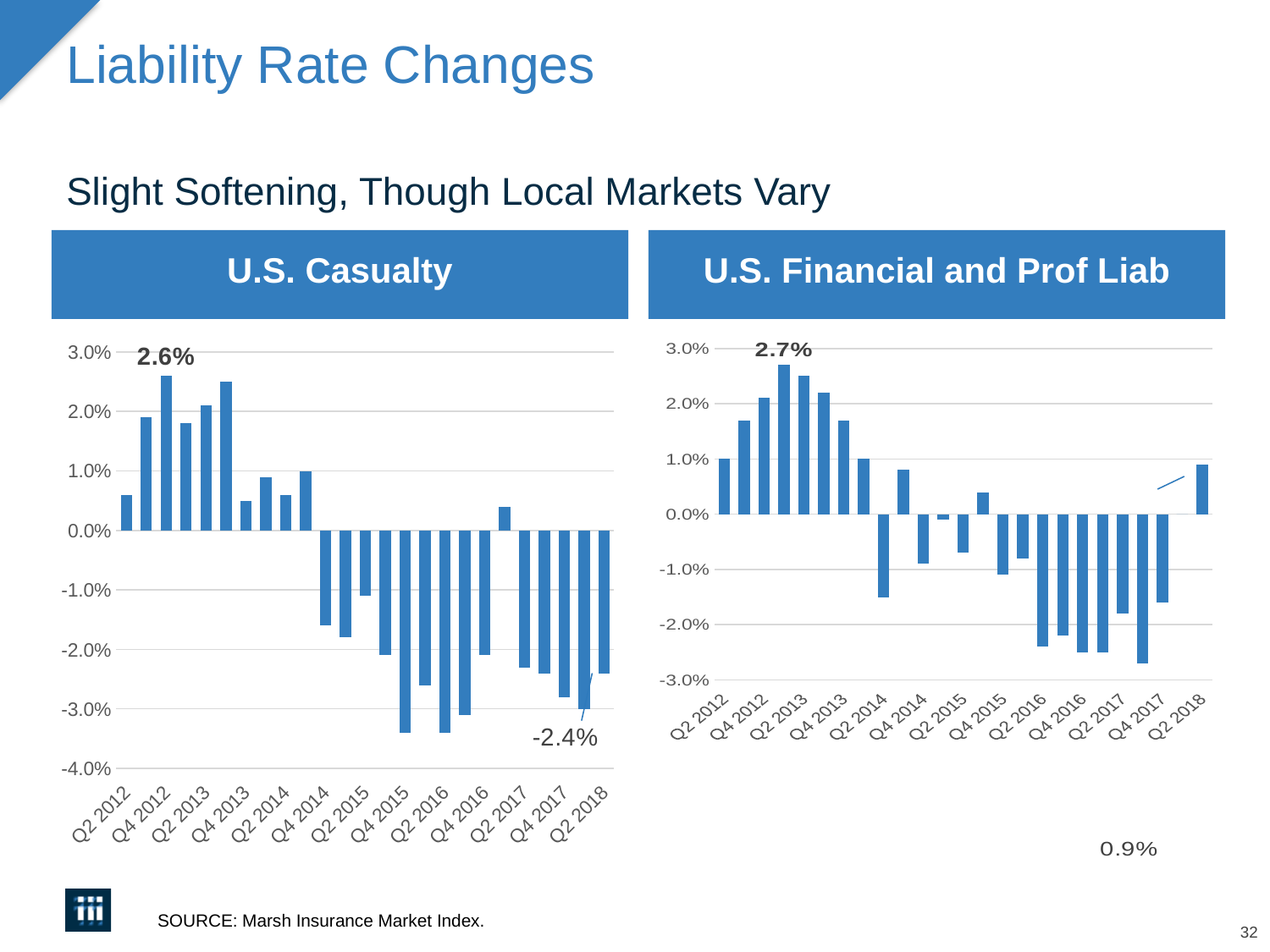
In the U.S. Casualty chart, what is the value for Q2 2018? -2.4% In the U.S. Casualty chart, is the value for Q2 2012 greater or less than 1.0%? less In the U.S. Financial and Prof Liab chart, what is the difference between the labeled peak value and the Q2 2018 value? 1.8 percentage points In the U.S. Financial and Prof Liab chart, what is the highest rate change value labeled? 2.7% In the U.S. Casualty chart, do the rate changes generally rise or fall from Q2 2012 to Q2 2018? fall In the U.S. Financial and Prof Liab chart, what is the value for Q2 2018? 0.9% Which chart shows the larger value for Q2 2018, U.S. Casualty or U.S. Financial and Prof Liab? U.S. Financial and Prof Liab What source is cited for the charts on the slide? Marsh Insurance Market Index In the U.S. Casualty chart, is the value for Q4 2015 greater or less than -3.0%? less What kind of chart is the U.S. Casualty chart? Bar chart In the U.S. Casualty chart, what is the difference between the labeled peak value and the Q2 2018 value? 5.0 percentage points In the U.S. Casualty chart, what is the highest rate change value labeled? 2.6%